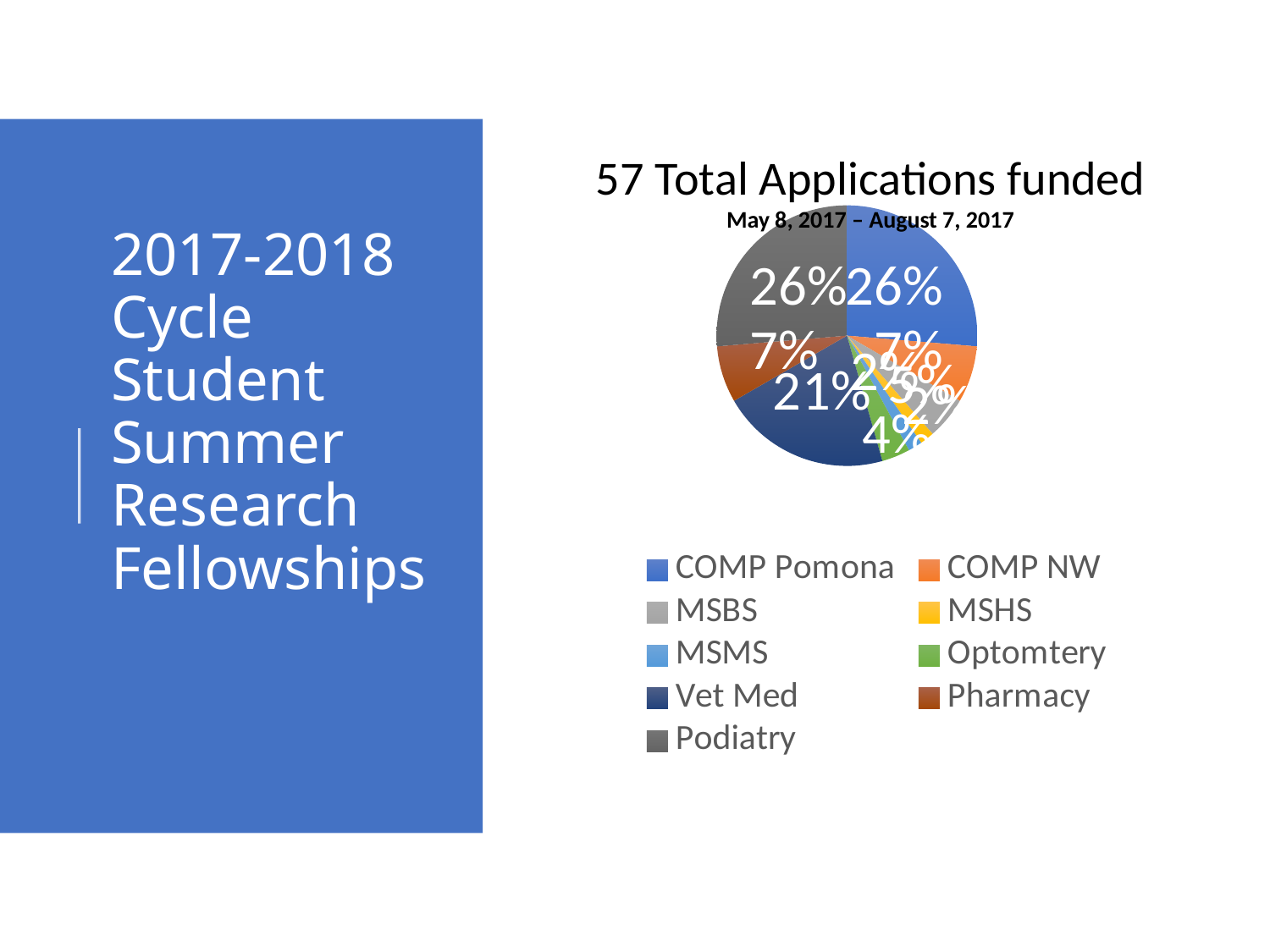
What share of the pie does COMP NW represent? 7% What share of the pie does Podiatry represent? 26% What share of the pie does Vet Med represent? 21% What kind of chart is shown on the slide? pie chart How many percentage points larger is the COMP Pomona share than the Vet Med share? 5 What share of the pie does COMP Pomona represent? 26% How many categories does the legend list? 9 Which has the larger share, COMP Pomona or COMP NW? COMP Pomona What is the title of the chart? 57 Total Applications funded What share of the pie does Pharmacy represent? 7% What date range is shown under the chart title? May 8, 2017 – August 7, 2017 Which has the larger share, Vet Med or Pharmacy? Vet Med